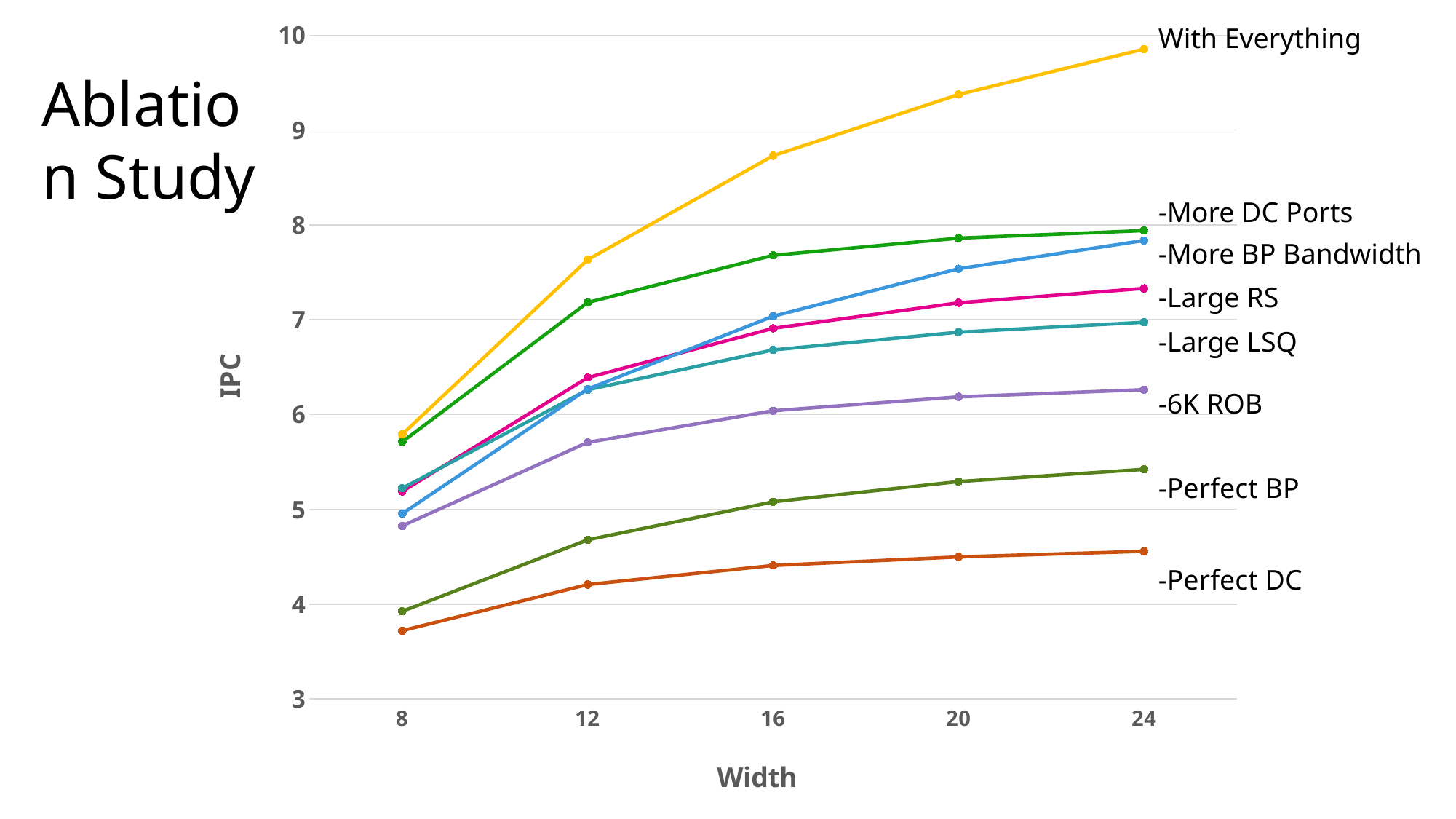
Which series has the highest IPC at Width 24? With Everything How many series are plotted on the chart? 8 What is the label of the y axis? IPC Which has the higher IPC at Width 20: -More DC Ports or -Large RS? -More DC Ports Does the IPC for With Everything rise or fall as Width increases from 8 to 24? rise Is the IPC for With Everything at Width 16 greater or less than 8? greater Is the IPC for -6K ROB at Width 24 greater or less than 7? less Is the IPC for -Perfect DC at Width 8 greater or less than 4? less What kind of chart is shown on the slide? line chart Which series has the lowest IPC at Width 24? -Perfect DC How many Width values are plotted along the x axis? 5 What is the label of the x axis? Width